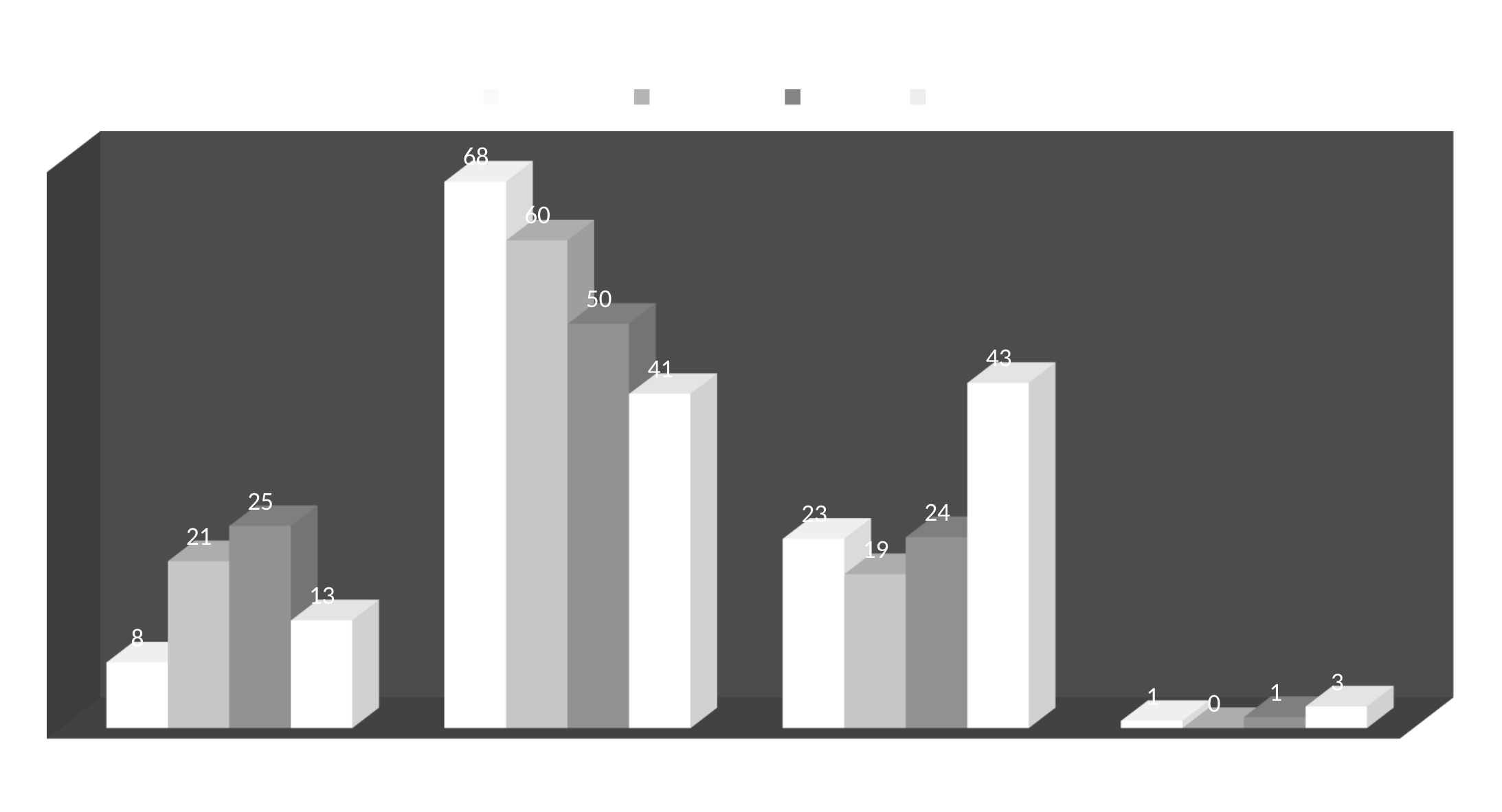
What is the value of the first (leftmost) bar in the first group? 8 In the first group, which is larger: the second bar or the third bar? the third bar (25) What is the value of the fourth (rightmost) bar in the third group? 43 What is the value of the second bar in the fourth (rightmost) group? 0 How many series does the legend list? 4 How many groups of bars are plotted along the x axis? 4 What is the highest value labelled anywhere on the chart? 68 What is the difference between the third bar (24) and the second bar (19) in the third group? 5 What is the difference between the first bar (68) and the fourth bar (41) in the second group? 27 What is the value of the tallest bar in the second group from the left? 68 What is the lowest value labelled anywhere on the chart? 0 What kind of chart is shown on the slide? bar chart